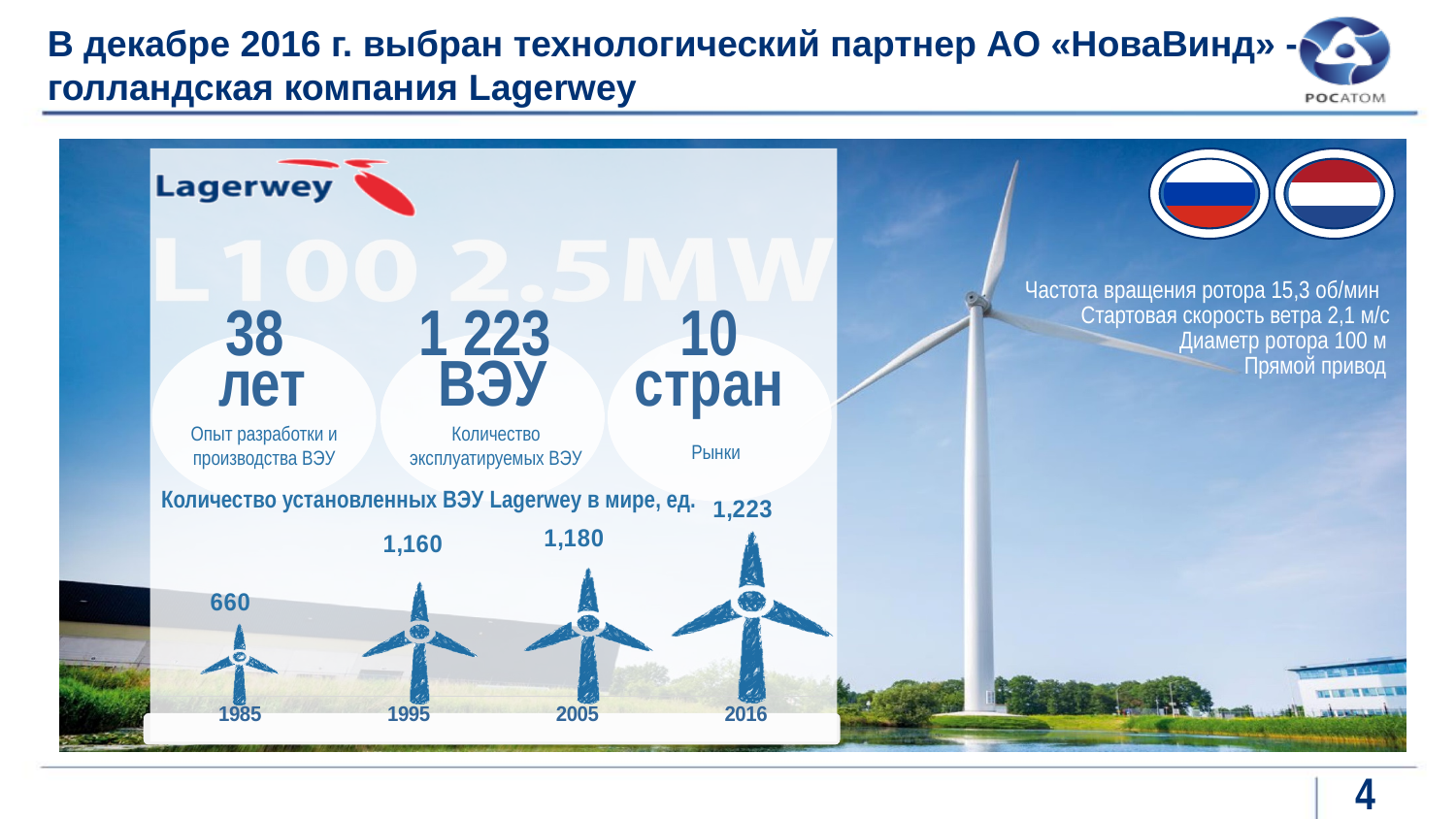
In the chart 'Количество установленных ВЭУ Lagerwey в мире, ед.', what is the difference between the values for 1995 and 1985? 500 What is the title of the chart on the slide? Количество установленных ВЭУ Lagerwey в мире, ед. What is the value for 2016 in the chart 'Количество установленных ВЭУ Lagerwey в мире, ед.'? 1,223 In the chart 'Количество установленных ВЭУ Lagerwey в мире, ед.', what is the difference between the values for 2016 and 1985? 563 Which year has the lowest value in the chart 'Количество установленных ВЭУ Lagerwey в мире, ед.'? 1985 What is the value for 1995 in the chart 'Количество установленных ВЭУ Lagerwey в мире, ед.'? 1,160 How many years (data points) are shown in the chart 'Количество установленных ВЭУ Lagerwey в мире, ед.'? 4 Do the values in the chart 'Количество установленных ВЭУ Lagerwey в мире, ед.' rise or fall from 1985 to 2016? rise Which year has the highest value in the chart 'Количество установленных ВЭУ Lagerwey в мире, ед.'? 2016 What is the value for 1985 in the chart 'Количество установленных ВЭУ Lagerwey в мире, ед.'? 660 In the chart 'Количество установленных ВЭУ Lagerwey в мире, ед.', which is larger: the value for 2005 or the value for 1995? 2005 What is the value for 2005 in the chart 'Количество установленных ВЭУ Lagerwey в мире, ед.'? 1,180